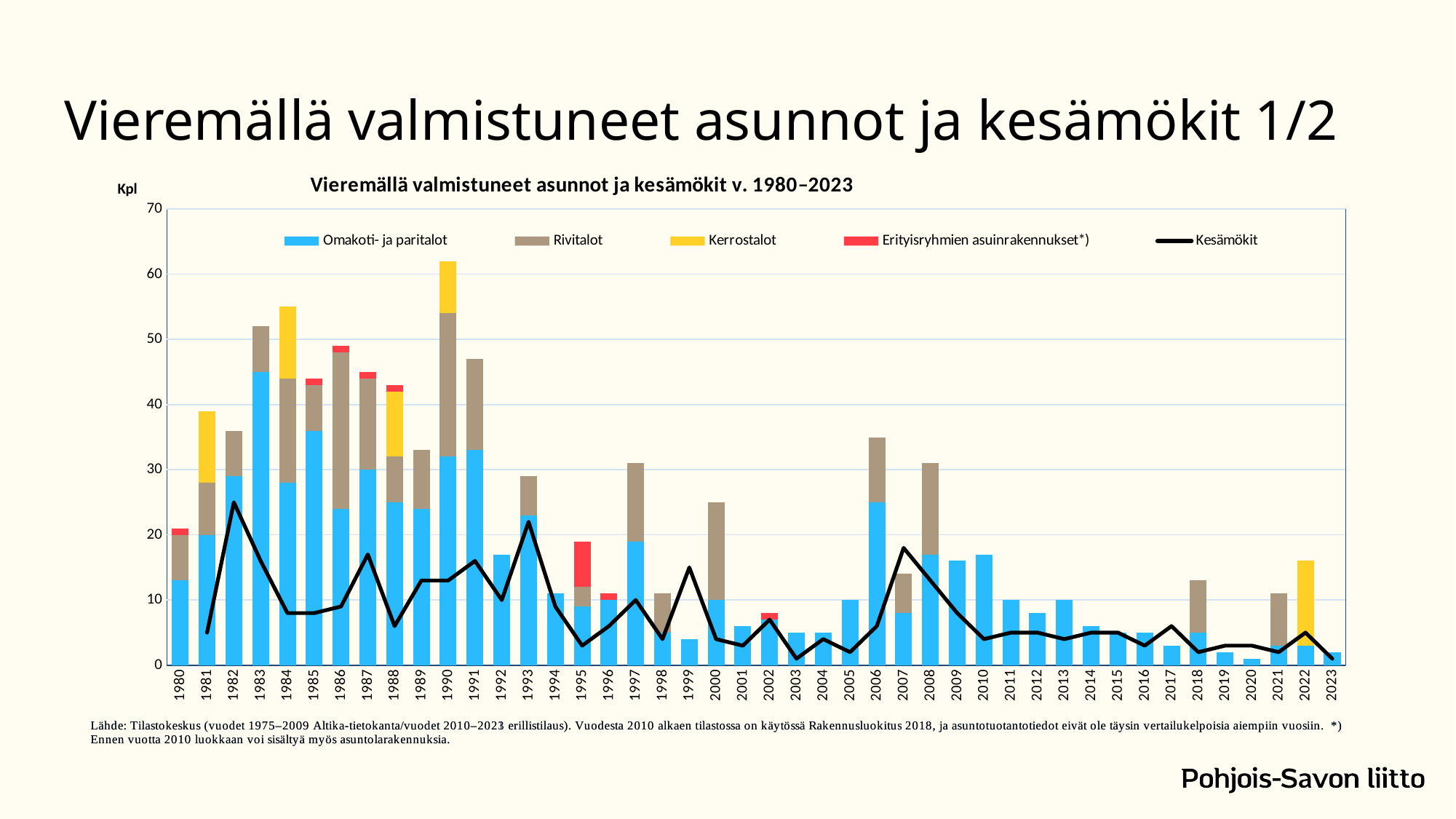
Is the Kesämökit value for 1982 greater or less than 20? greater Do the total stacked bars generally rise or fall from 2009 to 2023? fall Which year has the larger total stacked bar, 1993 or 1994? 1993 What colour represents Kerrostalot in the legend? Yellow How many series does the legend list? 5 Is the total stacked bar for 2006 greater or less than 30? greater Which year has the highest total stacked bar? 1990 Which year has the larger total stacked bar, 2006 or 2008? 2006 Is the total stacked bar for 1990 greater or less than 60? greater Which year has the lowest total stacked bar? 2020 How many years are shown on the x axis? 44 What type of chart is shown on the slide? Stacked bar chart with a line